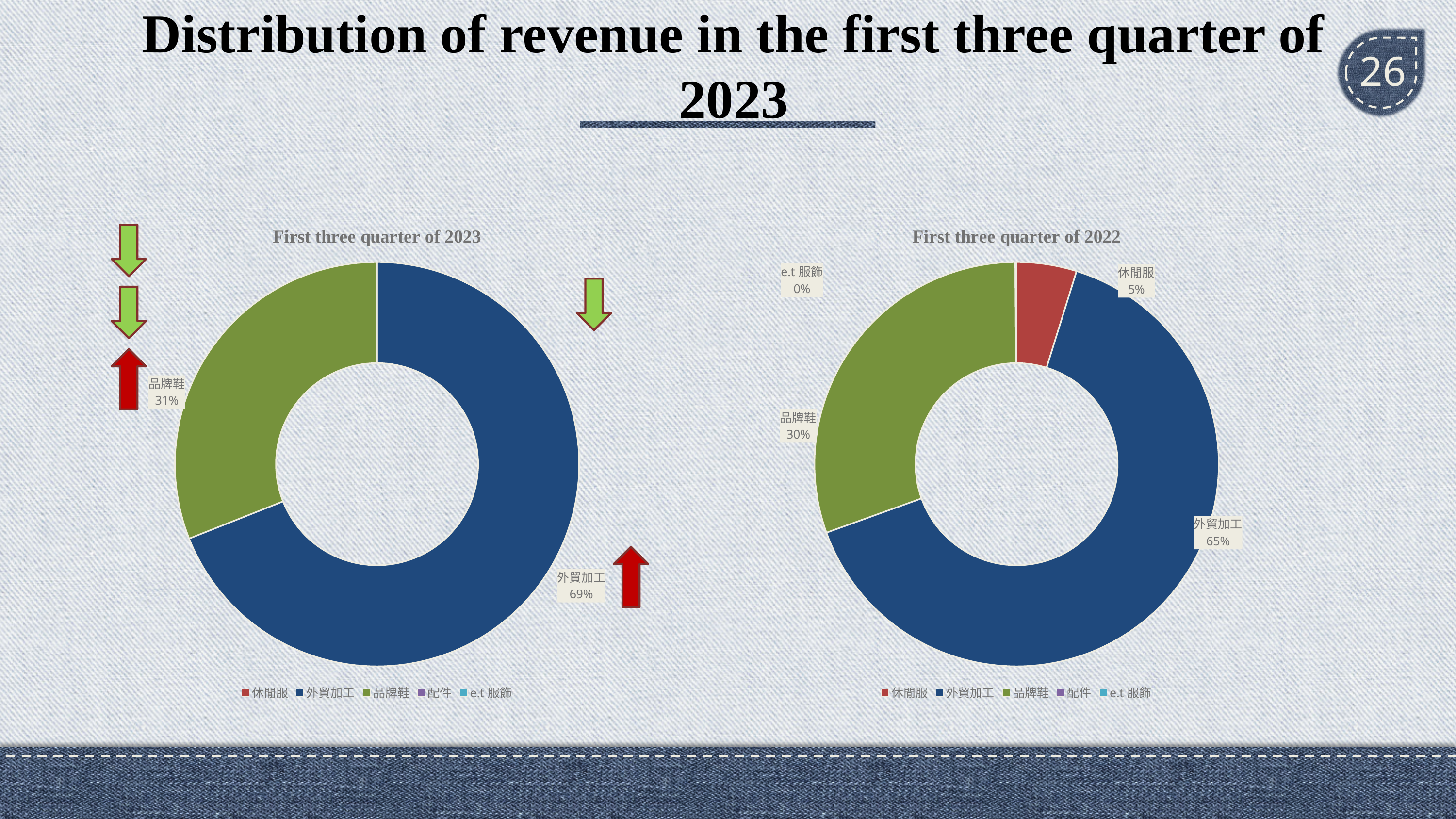
In the 'First three quarter of 2022' chart, which labelled category has the smallest share? e.t 服飾 In the 'First three quarter of 2023' chart, what share of revenue does 品牌鞋 account for? 31% In the 'First three quarter of 2022' chart, which labelled category has the largest share? 外貿加工 In the 'First three quarter of 2022' chart, what share is shown for e.t 服飾? 0% In the 'First three quarter of 2022' chart, what share of revenue does 休閒服 account for? 5% What is the title of the chart on the right side of the slide? First three quarter of 2022 In the 'First three quarter of 2023' chart, what is the difference in percentage points between 外貿加工 and 品牌鞋? 38 How many entries does the legend of the 'First three quarter of 2022' chart list? 5 Is the share of 外貿加工 larger in the 'First three quarter of 2023' chart or the 'First three quarter of 2022' chart? First three quarter of 2023 What kind of chart is the 'First three quarter of 2023' chart? Doughnut (pie) chart In the 'First three quarter of 2022' chart, what share of revenue does 外貿加工 account for? 65% In the 'First three quarter of 2023' chart, what share of revenue does 外貿加工 account for? 69%